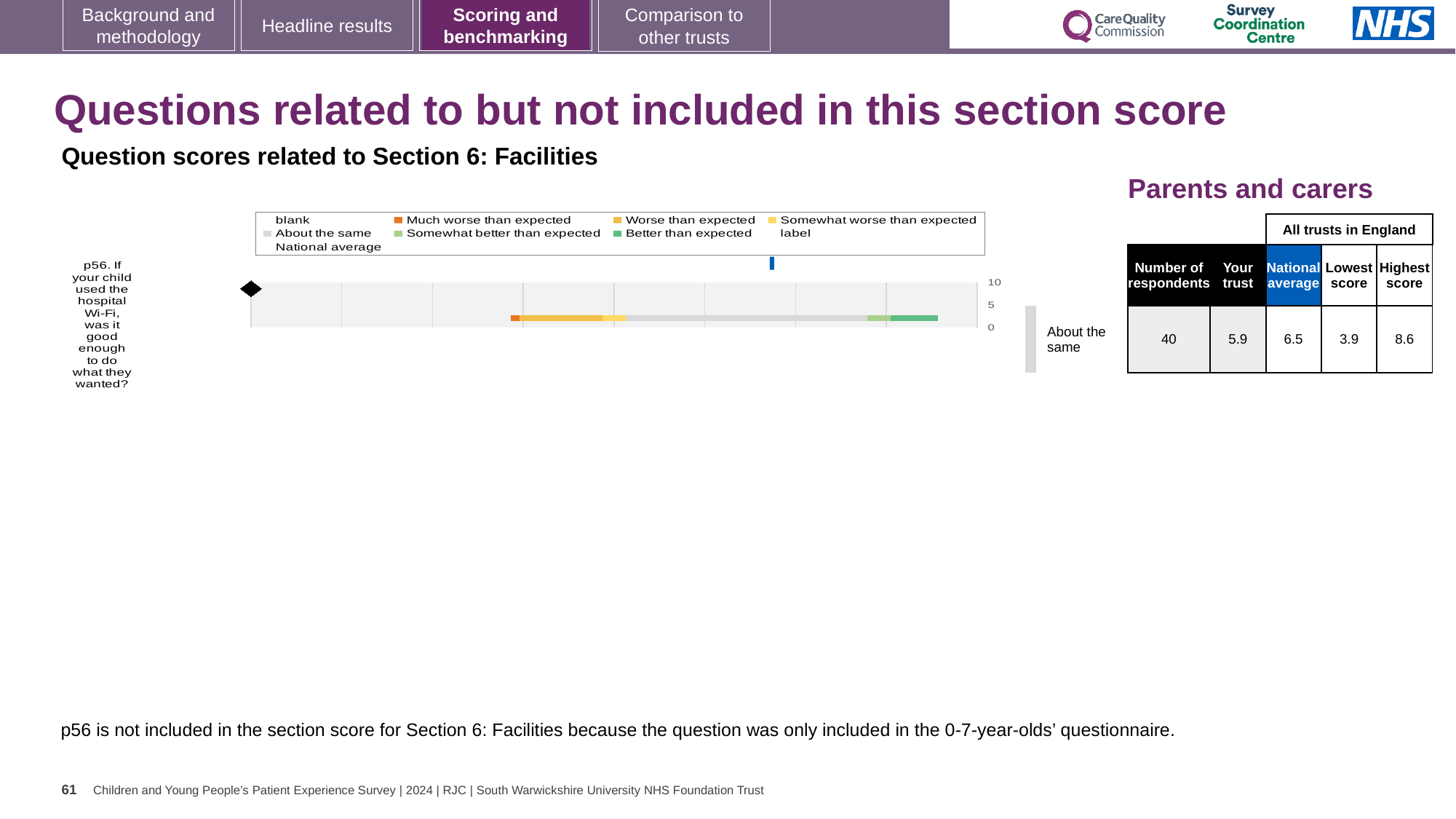
Which question is plotted in the chart? p56. If your child used the hospital Wi-Fi, was it good enough to do what they wanted? What is the highest tick value shown on the chart's score axis? 10 For p56, which is larger: the 'Your trust' score or the national average? National average For p56, what is the difference between the highest score and the lowest score among all trusts in England? 4.7 What kind of chart is shown for question p56? bar chart How many entries does the chart legend list? 9 According to the table beside the chart, what is the national average score for p56? 6.5 According to the table beside the chart, what is the lowest score among all trusts in England for p56? 3.9 How many questions (categories) are plotted in the chart? 1 According to the table beside the chart, what is the 'Your trust' score for p56? 5.9 According to the table beside the chart, what is the highest score among all trusts in England for p56? 8.6 According to the table beside the chart, how many respondents answered p56? 40